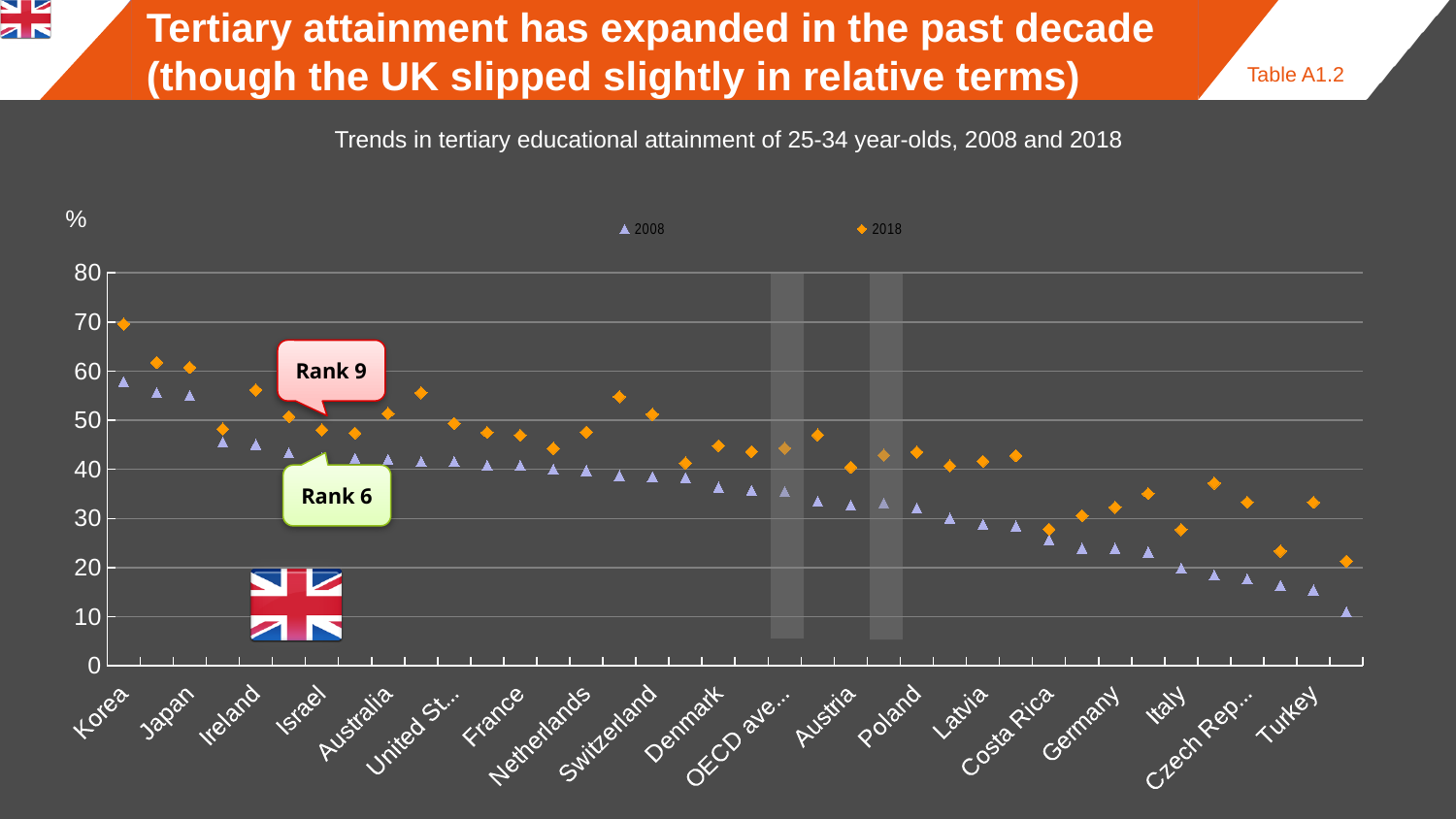
Do the 2018 values generally rise or fall moving from Korea on the left to Turkey on the right? fall For Korea, which is larger, the 2008 value or the 2018 value? 2018 Is the 2018 value for Korea greater or less than 60? greater Which country has the highest 2018 value? Korea What is the subtitle describing the chart? Trends in tertiary educational attainment of 25-34 year-olds, 2008 and 2018 Is the 2018 value for Turkey greater or less than 30? greater What are the two series shown in the legend? 2008 and 2018 Is the 2008 value for Turkey greater or less than 20? less How many series does the legend list? 2